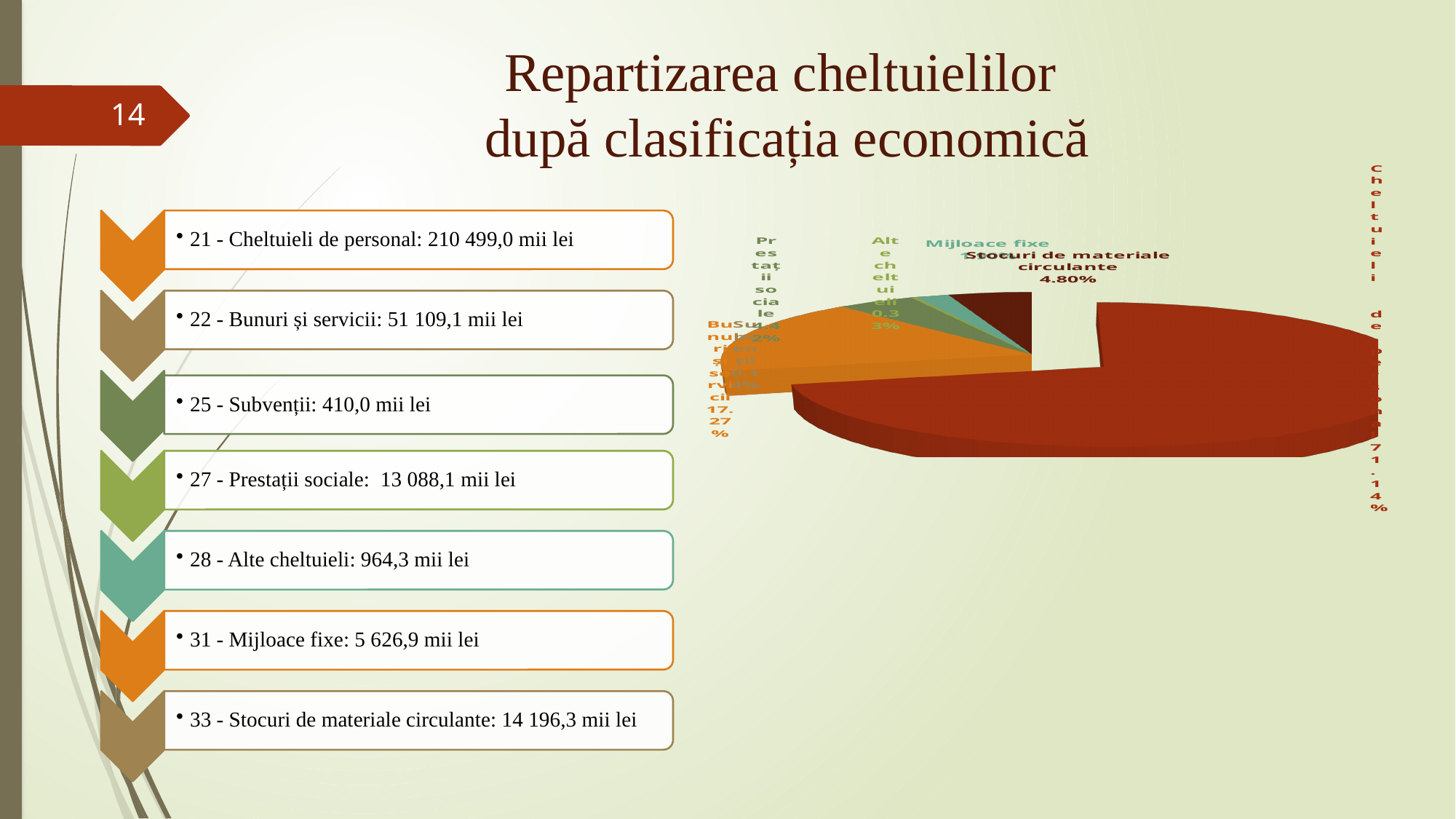
What share of the pie does Cheltuieli de personal represent? 71.14% What share of the pie does Alte cheltuieli represent? 0.33% Which category has the largest slice of the pie chart? Cheltuieli de personal How many expenditure categories are shown on the slide? 7 What is the title of the slide containing the pie chart? Repartizarea cheltuielilor după clasificația economică Which slice is larger: Bunuri și servicii or Stocuri de materiale circulante? Bunuri și servicii What share of the pie does Bunuri și servicii represent? 17.27% Which slice is larger: Cheltuieli de personal or Bunuri și servicii? Cheltuieli de personal What kind of chart is shown on the slide? pie chart What is the difference in percentage points between the shares of Cheltuieli de personal and Bunuri și servicii? 53.87